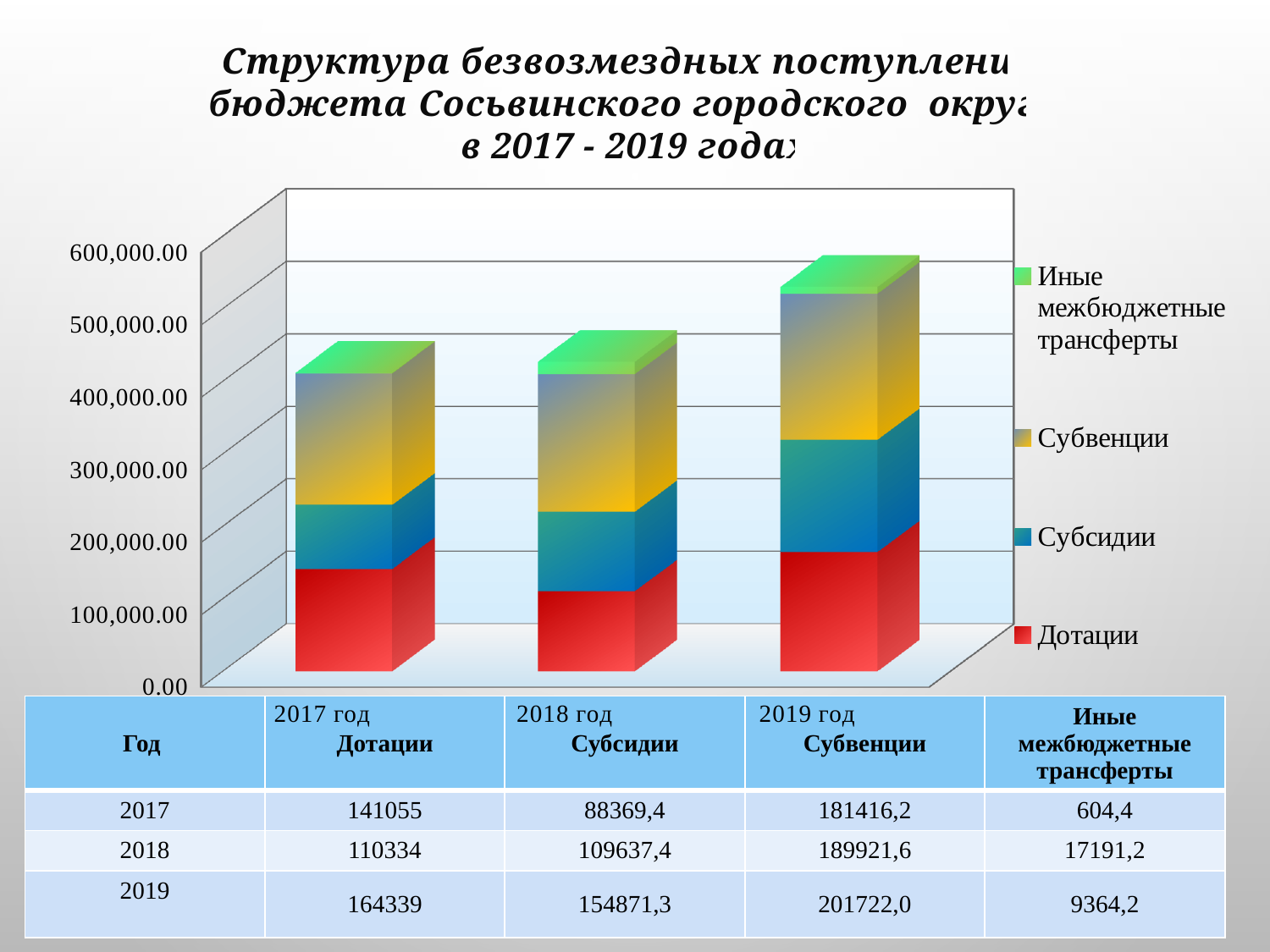
What is the value of Субсидии for 2019? 154871,3 What is the value of Дотации for 2017? 141055 Do the Субвенции values rise or fall from 2017 to 2019? rise What kind of chart is shown on the slide? Stacked bar chart What is the difference between the Субвенции values for 2019 and 2017? 20305,8 What is the value of Иные межбюджетные трансферты for 2018? 17191,2 In which year is the value of Иные межбюджетные трансферты the lowest? 2017 How many series does the chart legend list? 4 How many years (categories) are plotted in the chart? 3 In which year is the value of Дотации the highest? 2019 Which is larger, the Субсидии value for 2018 or for 2017? 2018 Is the total height of the 2019 stacked bar greater or less than 500,000.00? greater